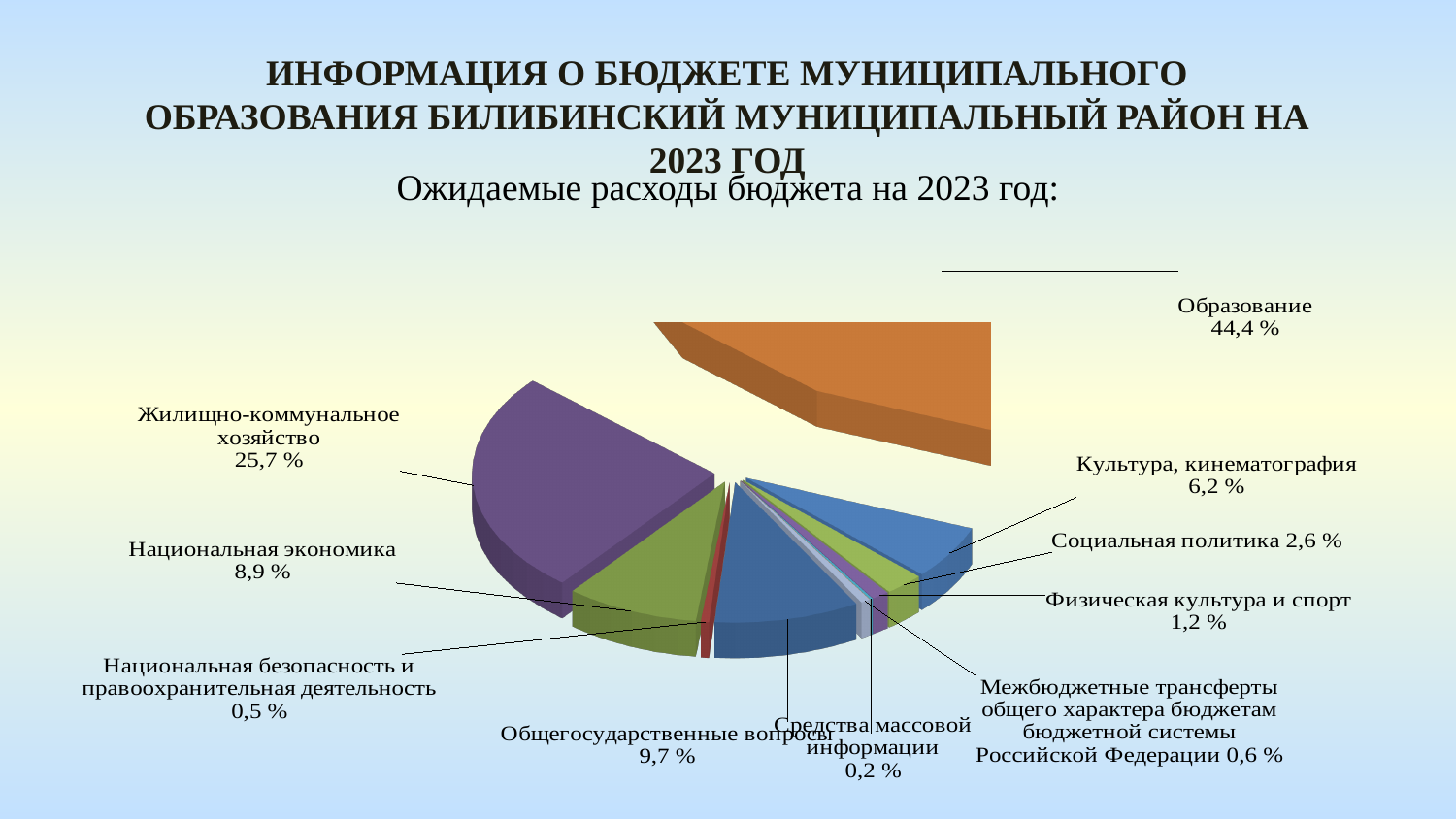
Which category has the largest share of the pie? Образование What is the value shown for Жилищно-коммунальное хозяйство? 25,7 % What is the value shown for Общегосударственные вопросы? 9,7 % Which category has the smallest share of the pie? Средства массовой информации How many categories are shown in the pie chart? 10 What is the value shown for Физическая культура и спорт? 1,2 % What is the difference between the shares of Образование and Жилищно-коммунальное хозяйство? 18,7 % Which is larger: the share for Общегосударственные вопросы or for Национальная экономика? Общегосударственные вопросы What is the value shown for Культура, кинематография? 6,2 % What kind of chart is shown on the slide? Pie chart What is the subtitle of the chart on the slide? Ожидаемые расходы бюджета на 2023 год: What share of expected 2023 budget expenditures goes to Образование? 44,4 %